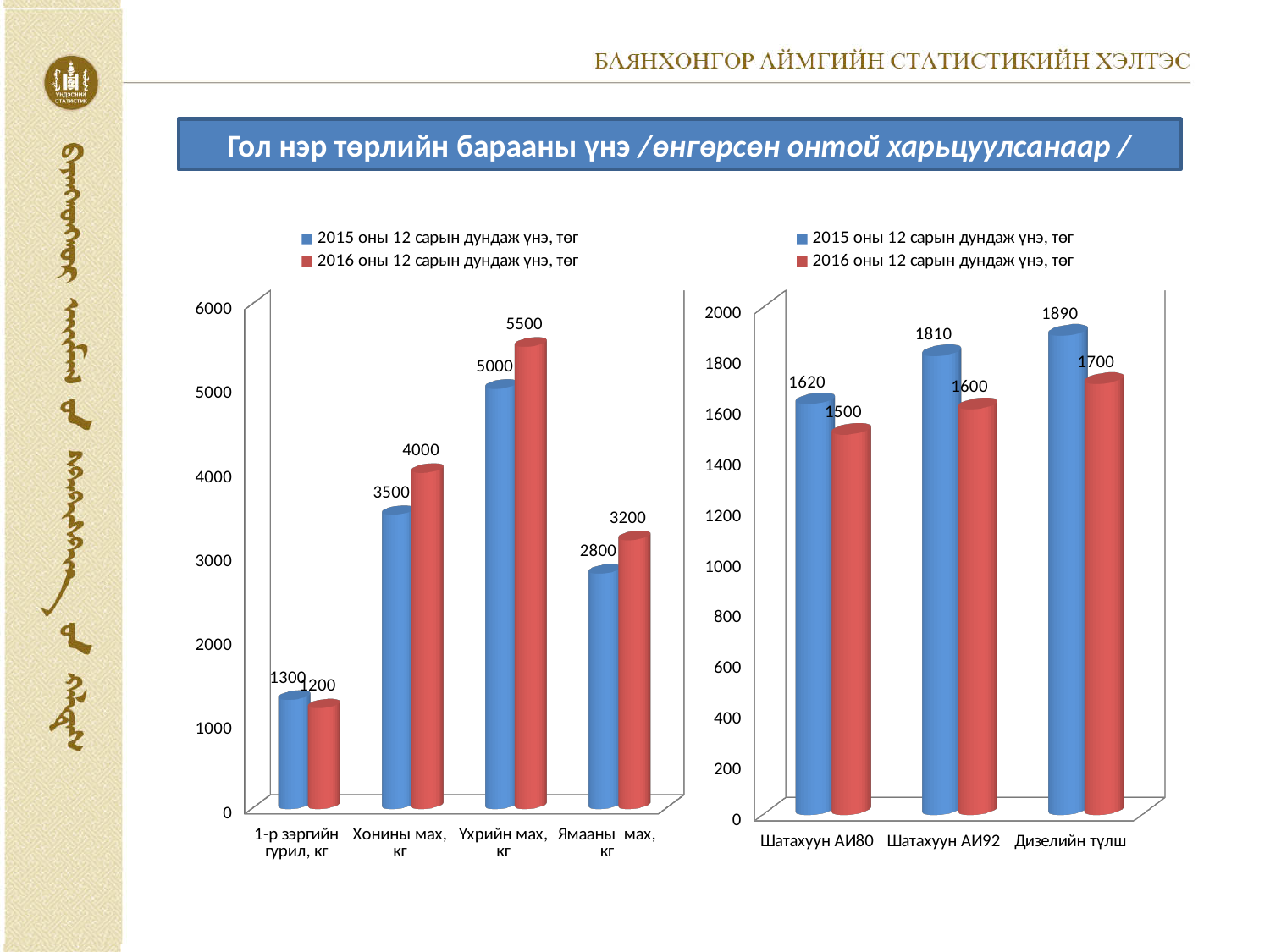
In the left chart, which category has the highest 2016 оны 12 сарын дундаж үнэ? Үхрийн мах, кг In the left chart, which is larger for 1-р зэргийн гурил, кг: the 2015 value or the 2016 value? 2015 value In the left chart, what is the 2016 оны 12 сарын дундаж үнэ for Үхрийн мах, кг? 5500 In the right chart, which category has the lowest 2015 оны 12 сарын дундаж үнэ? Шатахуун АИ80 In the right chart, what is the 2015 оны 12 сарын дундаж үнэ for Шатахуун АИ92? 1810 In the right chart, what is the difference between the 2015 and 2016 values for Шатахуун АИ92? 210 What type of chart is the left chart? Bar chart How many categories are shown in the right chart? 3 How many series does the legend of the left chart list? 2 In the left chart, what is the difference between the 2016 and 2015 values for Хонины мах, кг? 500 In the right chart, what is the 2016 оны 12 сарын дундаж үнэ for Дизелийн түлш? 1700 In the left chart, what is the 2015 оны 12 сарын дундаж үнэ for Ямааны мах, кг? 2800